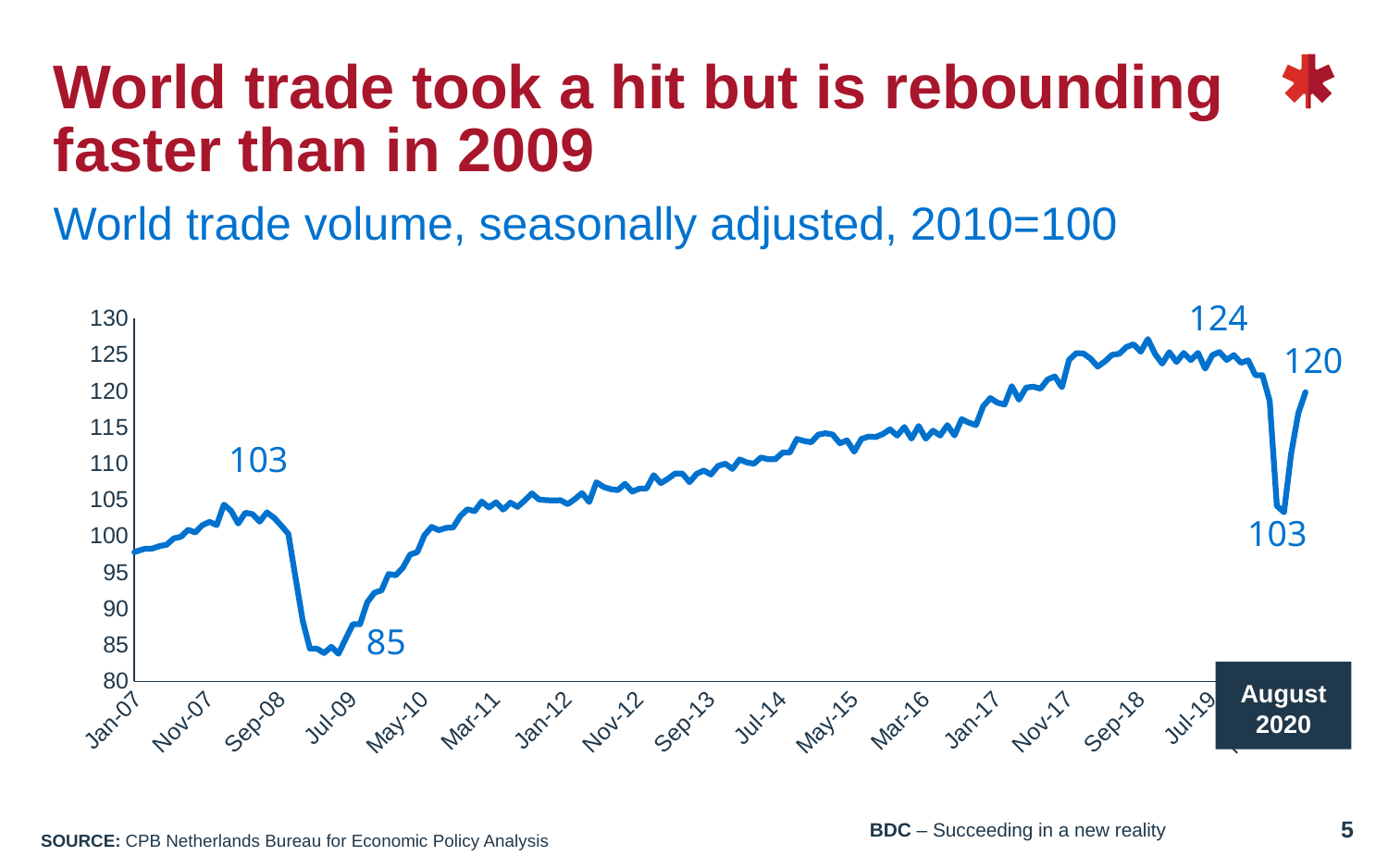
What is the highest labelled value of world trade volume on the chart? 124 What is the labelled value of world trade volume for August 2020? 120 By how much did world trade volume rise from the labelled 2020 trough to the August 2020 value? 17 Which labelled trough is higher: the 2009 trough or the 2020 trough? the 2020 trough What is the labelled value at the 2020 trough of the world trade volume line? 103 Does world trade volume generally rise or fall between Jul-09 and Sep-18? rise What is the lowest labelled value of world trade volume on the chart, reached in 2009? 85 What kind of chart is shown on the slide? line chart By how much did world trade volume fall from the labelled peak of 124 to the labelled 2020 trough? 21 Is the value of world trade volume at Sep-18 greater or less than 120? greater What is the labelled value at the peak of world trade volume before the 2009 downturn? 103 What is the difference between the labelled 2008 peak (103) and the labelled 2009 trough (85)? 18